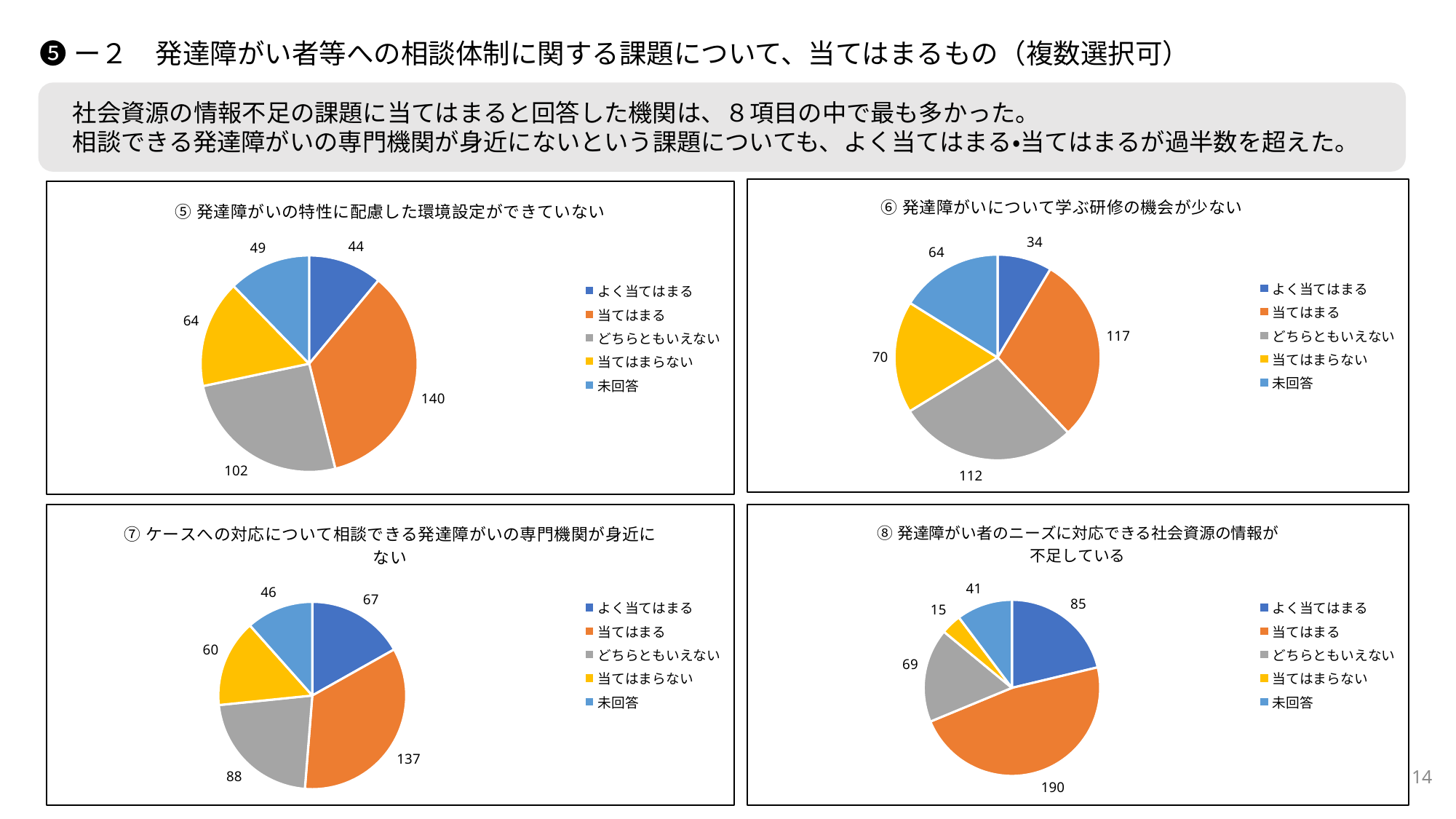
In the top-left pie chart (⑤), what is the value for 当てはまる? 140 How many entries does the legend of the top-right chart (⑥) list? 5 In the top-right pie chart (⑥), what is the difference between 当てはまる and どちらともいえない? 5 In the bottom-left pie chart (⑦), which category has the largest value? 当てはまる In the bottom-right pie chart (⑧), which category has the smallest value? 当てはまらない In the top-right pie chart (⑥), what is the value for どちらともいえない? 112 In the bottom-right pie chart (⑧), what is the total of all slices? 400 In the bottom-right pie chart (⑧), what share of the total does 当てはまる represent? 47.5% In the top-left pie chart (⑤), which is larger: 当てはまらない or 未回答? 当てはまらない What type of chart is used in the bottom-right chart (⑧)? pie chart How many slices does the bottom-left pie chart (⑦) have? 5 In the bottom-right pie chart (⑧), what is the value for 当てはまらない? 15